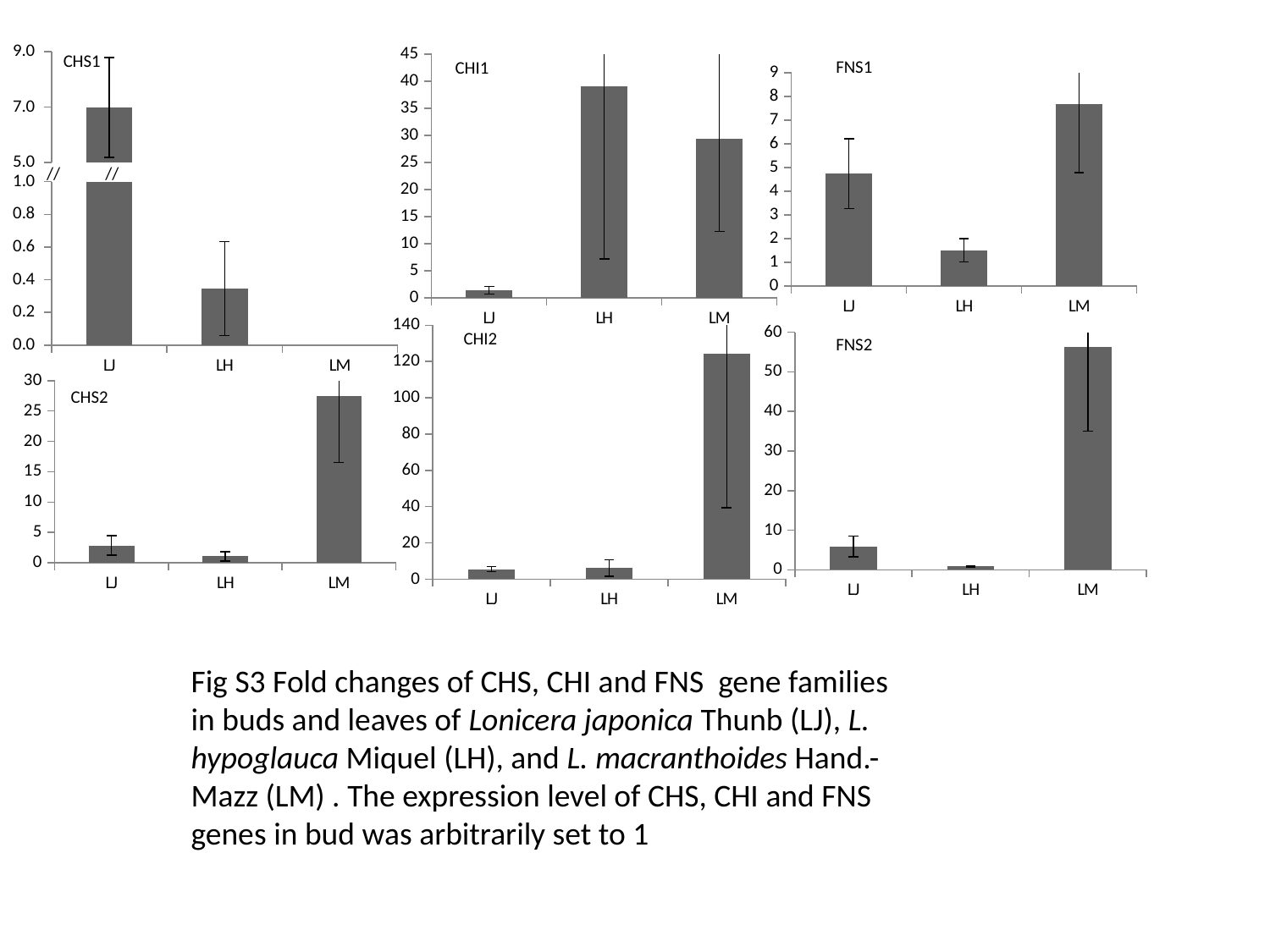
In the CHS2 chart, is the value for LJ greater or less than 5? less In the CHS1 chart, which is larger, the value for LJ or the value for LH? LJ What kind of chart is the FNS2 chart? bar chart In the FNS1 chart, which category has the lowest value? LH In the CHI2 chart, is the value for LM greater or less than 120? greater In the CHI1 chart, which category has the highest value? LH In the CHS2 chart, which category has the highest value? LM In the FNS1 chart, which is larger, the value for LJ or the value for LM? LM In the FNS2 chart, which category has the highest value? LM In the CHI1 chart, which category has the lowest value? LJ How many categories are shown on the x axis of the CHI1 chart? 3 In the FNS2 chart, is the value for LM greater or less than 50? greater